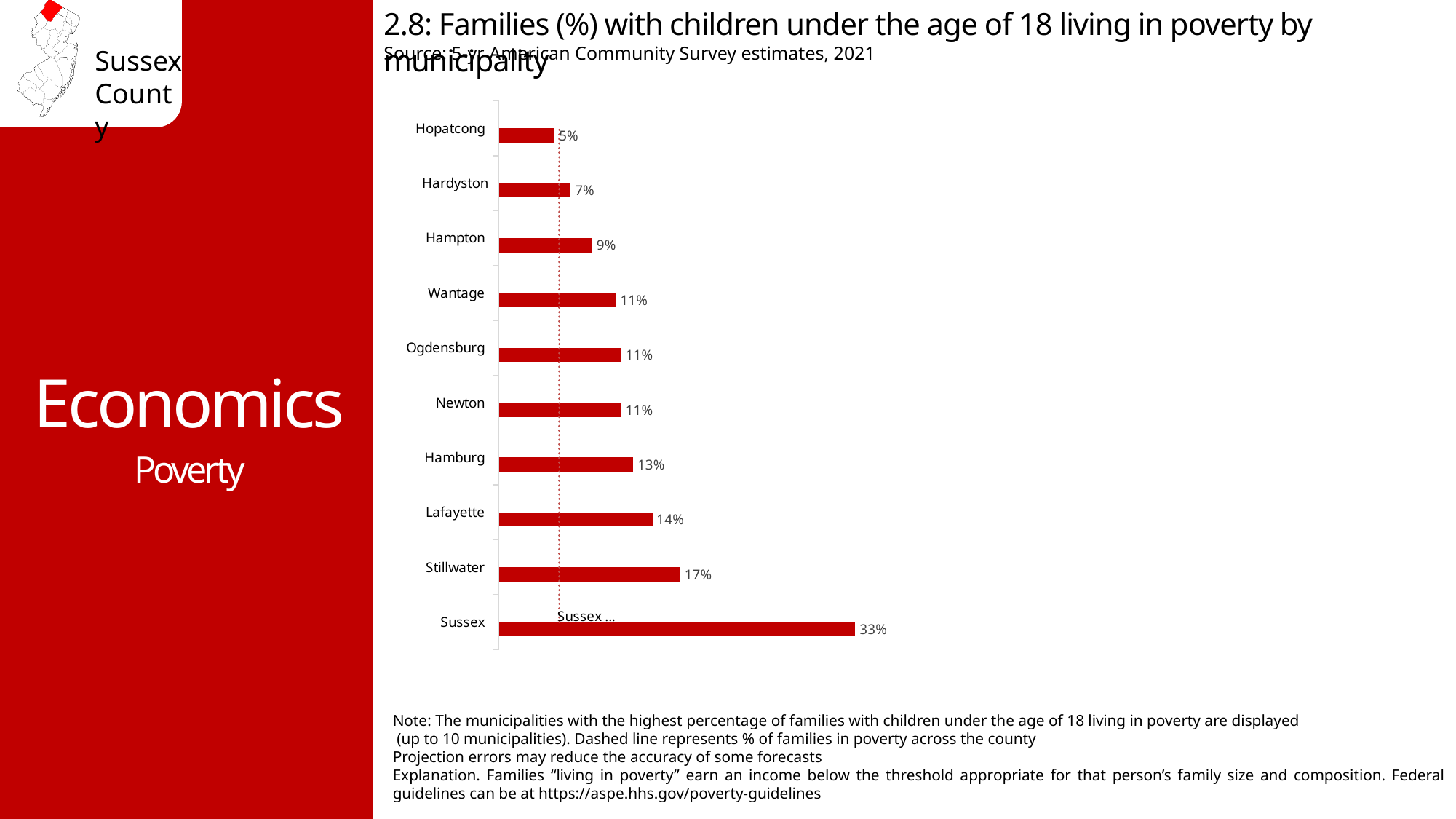
What kind of chart is shown on the slide? Bar chart What is the value for Stillwater? 17% How many municipalities are shown on the chart? 10 What is the value for Sussex? 33% What is the value for Lafayette? 14% What is the difference between the values for Sussex and Stillwater? 16% Which is larger, the value for Hampton or the value for Lafayette? Lafayette What is the difference between the values for Hamburg and Hardyston? 6% Which municipality has the lowest percentage shown on the chart? Hopatcong What is the value for Hopatcong? 5% What does the dashed vertical line on the chart represent? % of families in poverty across the county Which municipality has the highest percentage of families with children under 18 living in poverty? Sussex